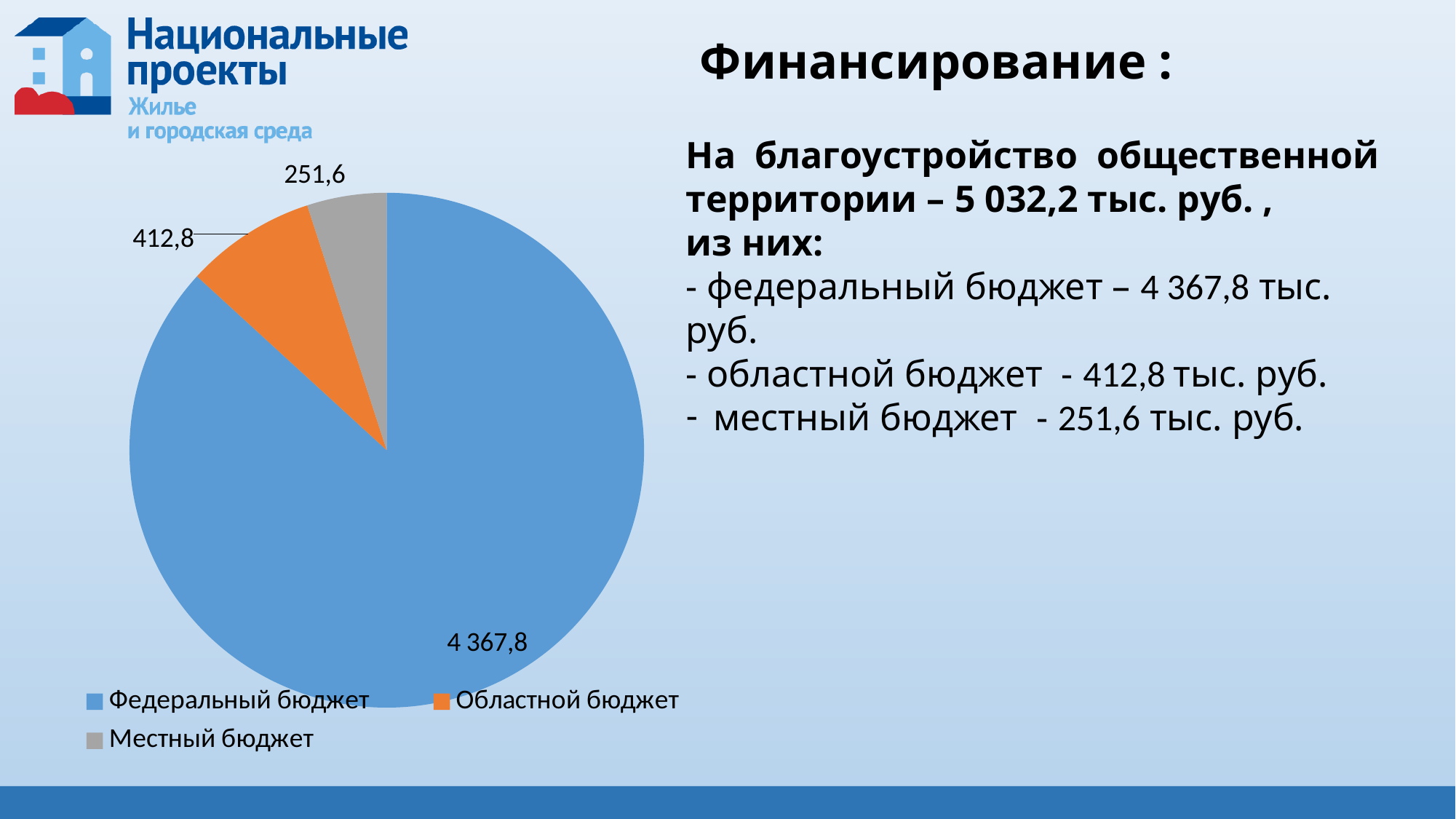
What is the total of all three slices in the pie chart? 5 032,2 Which category has the smallest slice in the pie chart? Местный бюджет What is the value for Местный бюджет in the pie chart? 251,6 How many entries does the legend of the pie chart list? 3 What type of chart is shown on the slide? Pie chart Which is larger: the value for Областной бюджет or the value for Местный бюджет? Областной бюджет What is the value for Федеральный бюджет in the pie chart? 4 367,8 Which category has the largest slice in the pie chart? Федеральный бюджет What colour is the slice for Областной бюджет in the pie chart? Orange What is the difference between the values for Областной бюджет and Местный бюджет? 161,2 What is the value for Областной бюджет in the pie chart? 412,8 How many slices does the pie chart have? 3